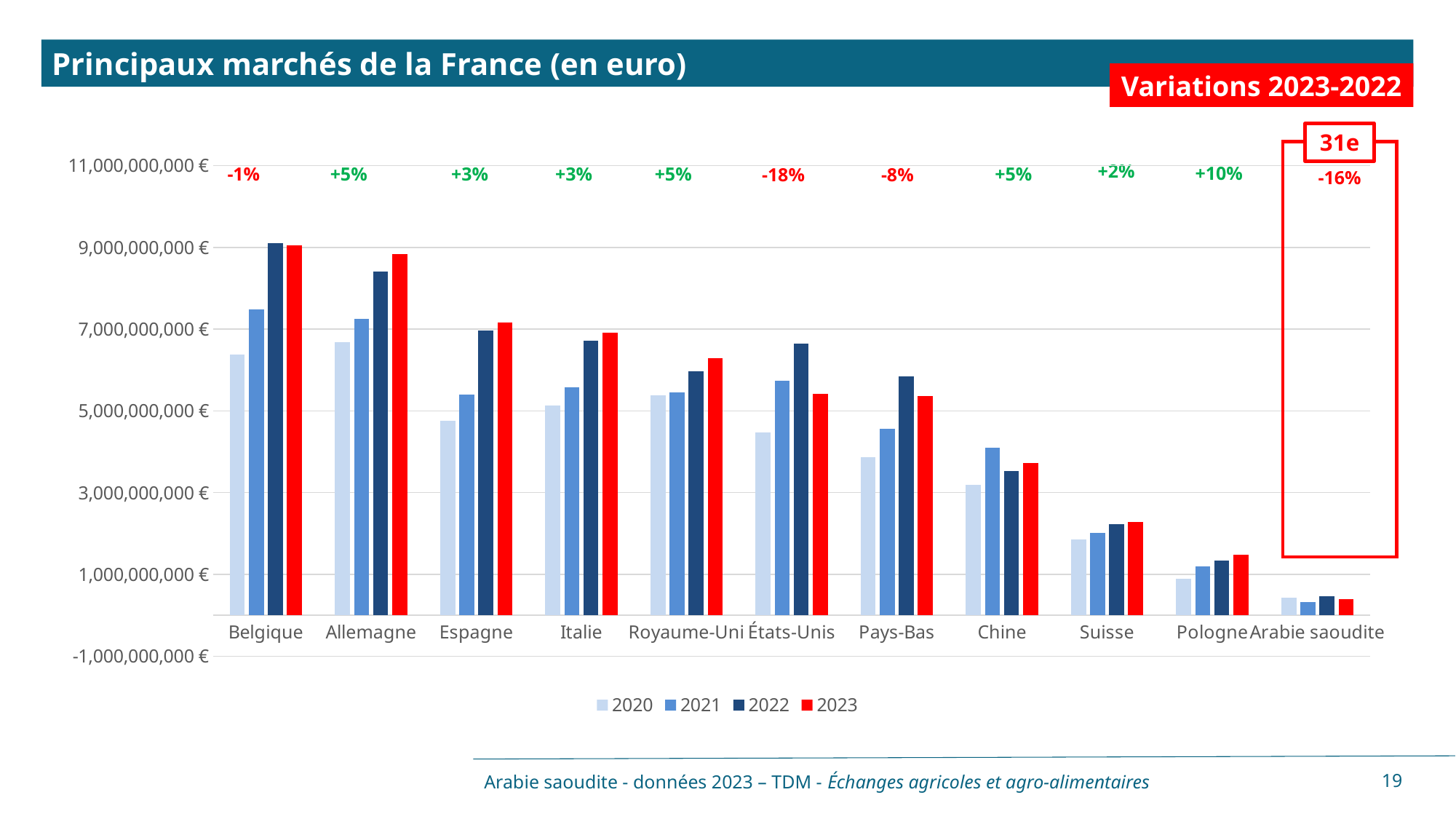
Do the values for Allemagne rise or fall from 2020 to 2023? rise How many countries are shown on the x axis of the chart? 11 What is the 2023-2022 variation shown for Pologne? +10% What is the 2023-2022 variation shown for Arabie saoudite? -16% For États-Unis, which is larger: the 2022 value or the 2023 value? 2022 Which country has the highest 2023 value? Belgique How many series does the legend list? 4 Is the 2023 value for Chine greater or less than 5,000,000,000 €? less What is the 2023-2022 variation shown for États-Unis? -18% Which country has the lowest 2023 value? Arabie saoudite Is the 2023 value for Allemagne greater or less than 7,000,000,000 €? greater What kind of chart is shown on the slide? bar chart